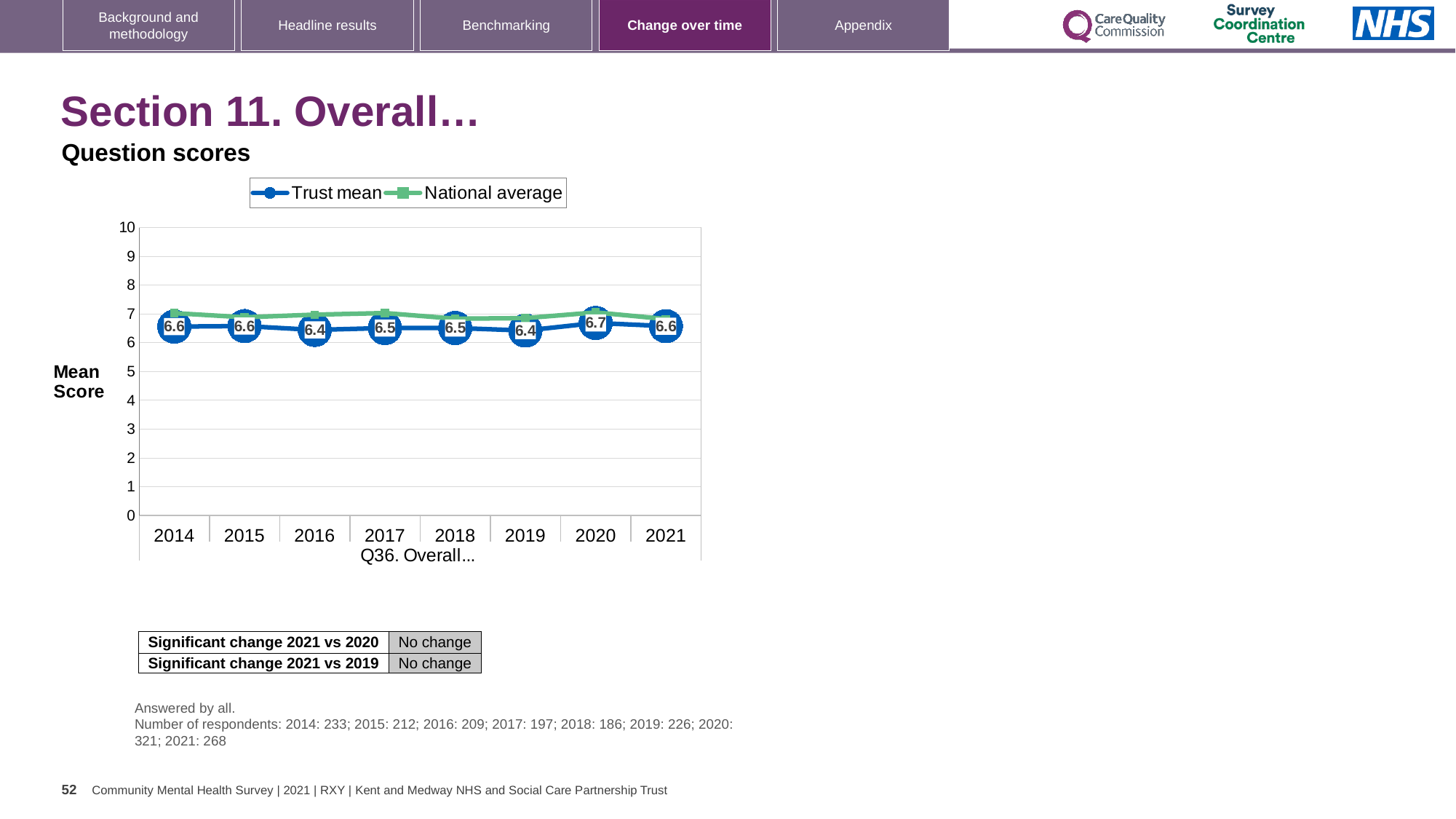
What is the difference between the Trust mean scores for 2020 and 2016? 0.3 What is the Trust mean score for 2020? 6.7 What are the two series named in the legend? Trust mean and National average What is the Trust mean score for 2021? 6.6 Which is larger, the Trust mean score for 2020 or for 2019? 2020 How many years are shown on the x axis of the chart? 8 Is the National average value for 2014 greater or less than 5? greater In which year is the Trust mean score highest? 2020 What is the Trust mean score for 2016? 6.4 How many series does the legend list? 2 What kind of chart is shown on the slide? Line chart What is the Trust mean score for 2017? 6.5